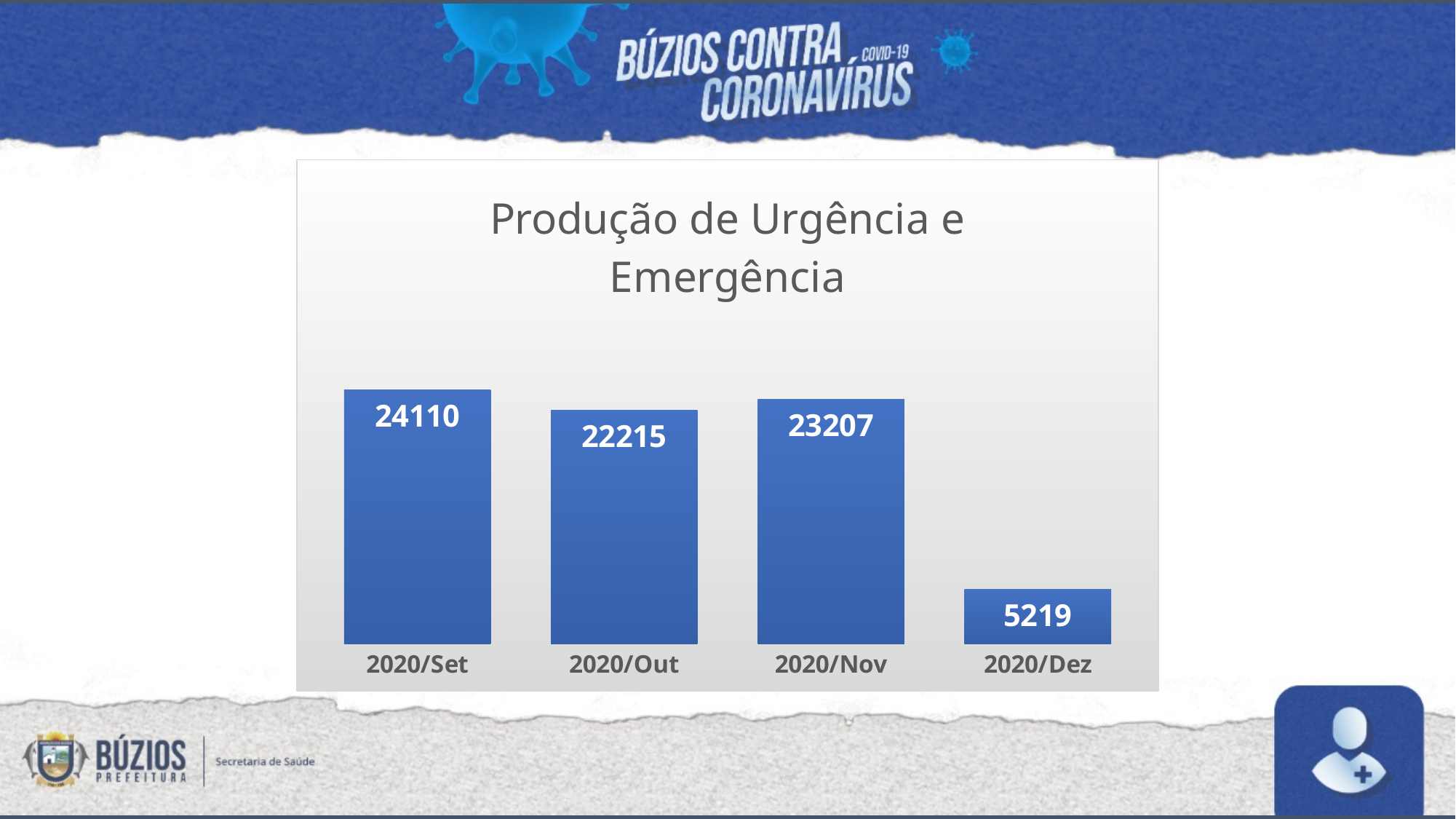
Which month has the lowest value? 2020/Dez Which month has the highest value? 2020/Set What is the difference between the values for 2020/Nov and 2020/Dez? 17988 What kind of chart is shown on the slide? bar chart How many months are shown in the chart? 4 What is the value for 2020/Nov? 23207 What is the value for 2020/Set? 24110 What is the value for 2020/Out? 22215 What is the title of the chart? Produção de Urgência e Emergência What is the value for 2020/Dez? 5219 Which is larger, the value for 2020/Nov or the value for 2020/Out? 2020/Nov What is the difference between the values for 2020/Set and 2020/Out? 1895